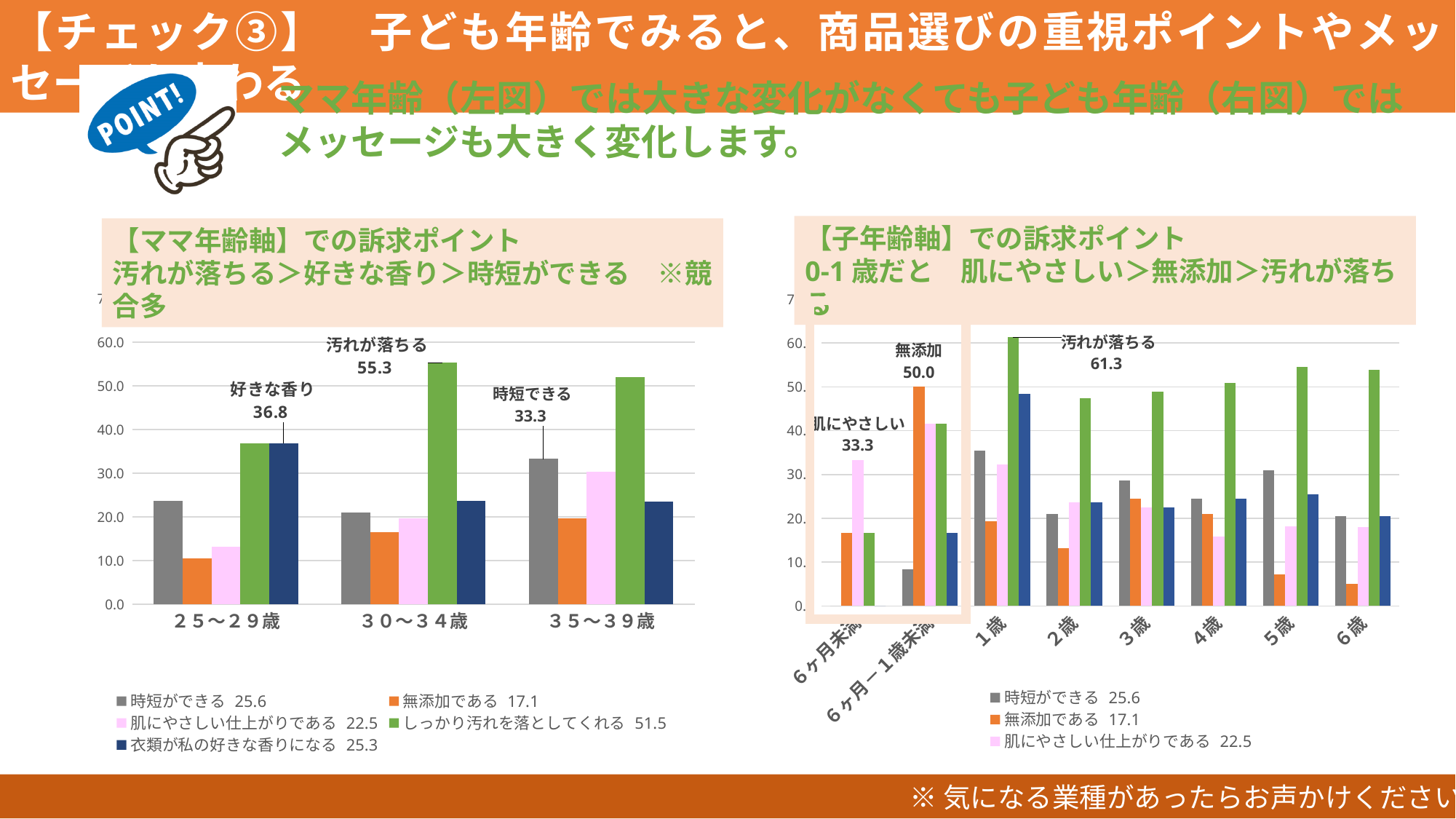
In the right chart (【子年齢軸】での訴求ポイント), what is the labelled value for 汚れが落ちる in the 1歳 group? 61.3 In the left chart (【ママ年齢軸】での訴求ポイント), what is the labelled value for 時短できる in the 35～39歳 group? 33.3 In the left chart (【ママ年齢軸】での訴求ポイント), how many series does the legend list? 5 In the right chart (【子年齢軸】での訴求ポイント), how many child-age categories are shown on the x axis? 8 In the left chart (【ママ年齢軸】での訴求ポイント), how many age categories are shown on the x axis? 3 In the left chart (【ママ年齢軸】での訴求ポイント), what is the labelled value for 汚れが落ちる in the 30～34歳 group? 55.3 In the left chart (【ママ年齢軸】での訴求ポイント), is the value for 無添加である in the 25～29歳 group greater or less than 20.0? less In the left chart (【ママ年齢軸】での訴求ポイント), which age group has the highest bar for しっかり汚れを落としてくれる? 30～34歳 What kind of chart is the left chart (【ママ年齢軸】での訴求ポイント)? bar chart In the left chart (【ママ年齢軸】での訴求ポイント), what is the labelled value for 好きな香り in the 25～29歳 group? 36.8 In the right chart (【子年齢軸】での訴求ポイント), is the value for 無添加である in the 6歳 group greater or less than 10? less In the right chart (【子年齢軸】での訴求ポイント), what is the labelled value for 無添加 in the 6ヶ月－1歳未満 group? 50.0